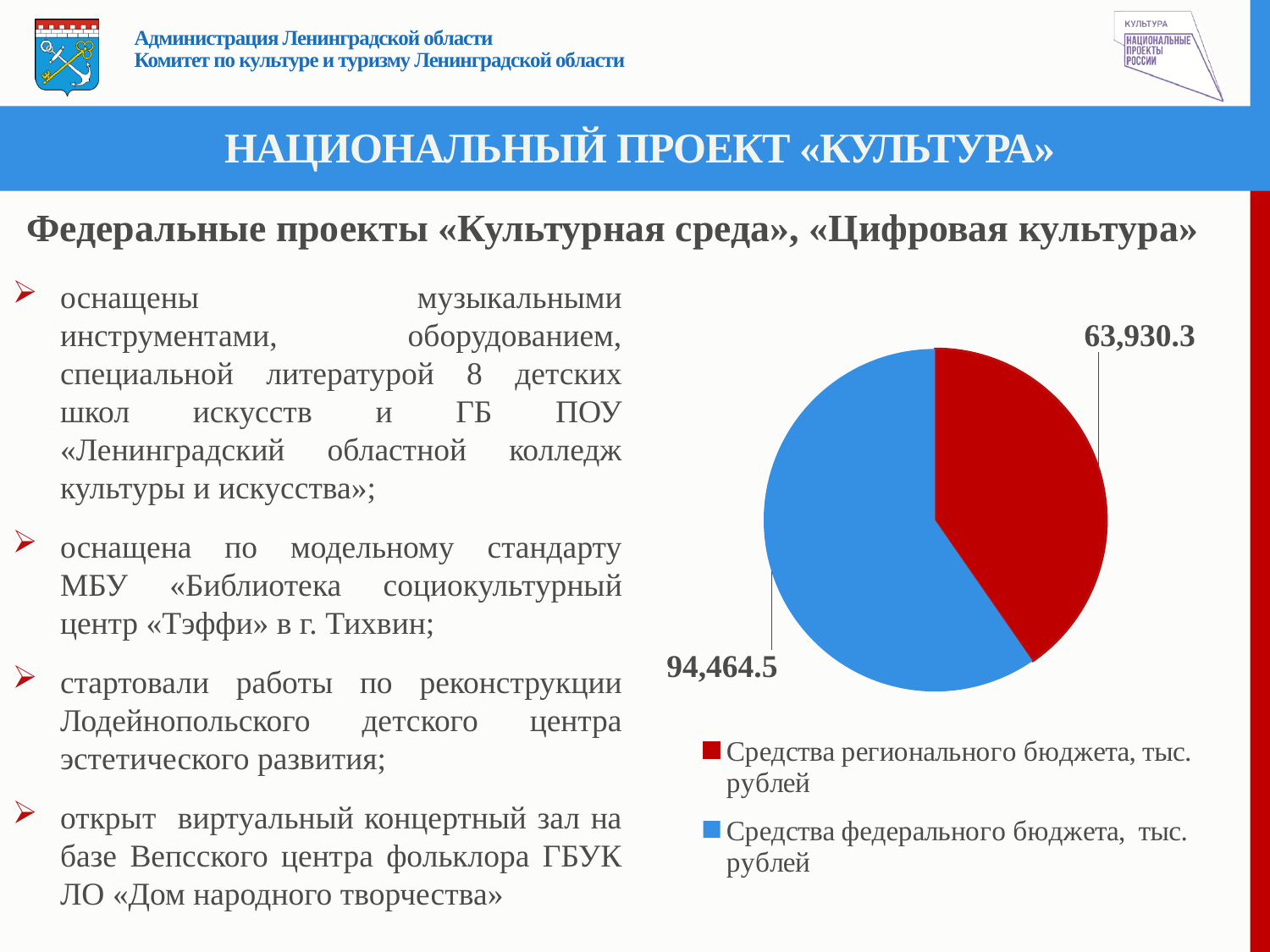
How many slices does the pie chart have? 2 What kind of chart is shown on the slide? pie chart What colour is the slice for Средства регионального бюджета in the pie chart? red What is the total of the two values shown in the pie chart? 158,394.8 What is the difference between the federal budget funds and the regional budget funds shown in the pie chart? 30,534.2 What is the value for Средства федерального бюджета, тыс. рублей in the pie chart? 94,464.5 Which is larger in the pie chart: the federal budget funds or the regional budget funds? Средства федерального бюджета, тыс. рублей Which slice of the pie chart is the largest? Средства федерального бюджета, тыс. рублей What is the value for Средства регионального бюджета, тыс. рублей in the pie chart? 63,930.3 How many entries does the legend of the pie chart list? 2 Which slice of the pie chart is the smallest? Средства регионального бюджета, тыс. рублей What colour is the slice for Средства федерального бюджета in the pie chart? blue